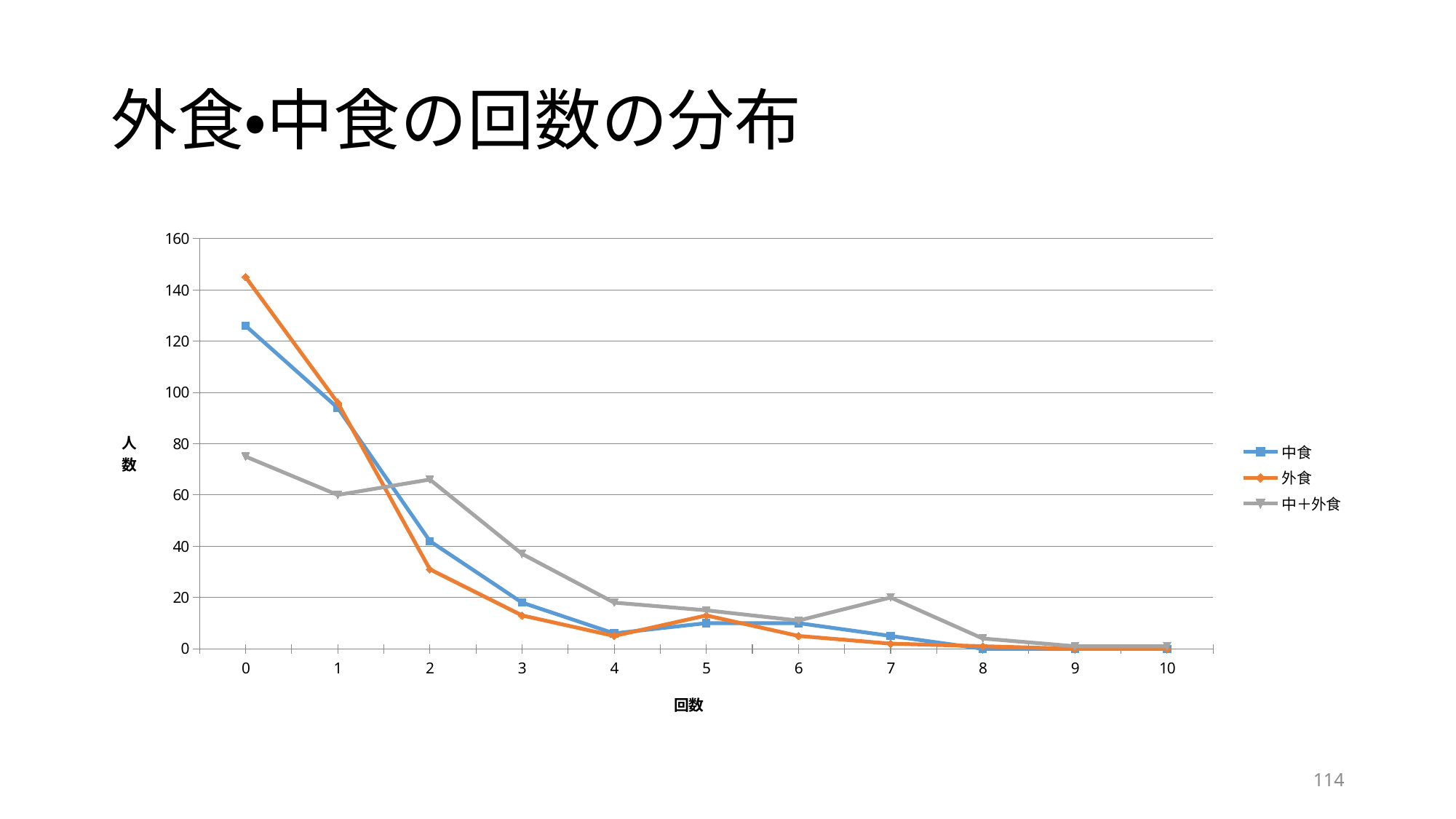
How many series does the legend list? 3 At 回数 3, which is larger: 中食 or 外食? 中食 Does the 外食 line rise or fall from 回数 0 to 回数 4? fall For the 中＋外食 series, at which 回数 is the value highest? 0 Is the value for 外食 at 回数 0 greater or less than 140? greater How many points (回数 values) are plotted along the x axis? 11 Is the value for 中食 at 回数 0 greater or less than 120? greater At 回数 2, which is larger: 中＋外食 or 中食? 中＋外食 Is the value for 中＋外食 at 回数 1 greater or less than 80? less What kind of chart is shown on the slide? line chart Which series has the highest value at 回数 0? 外食 What is the title of the x axis? 回数